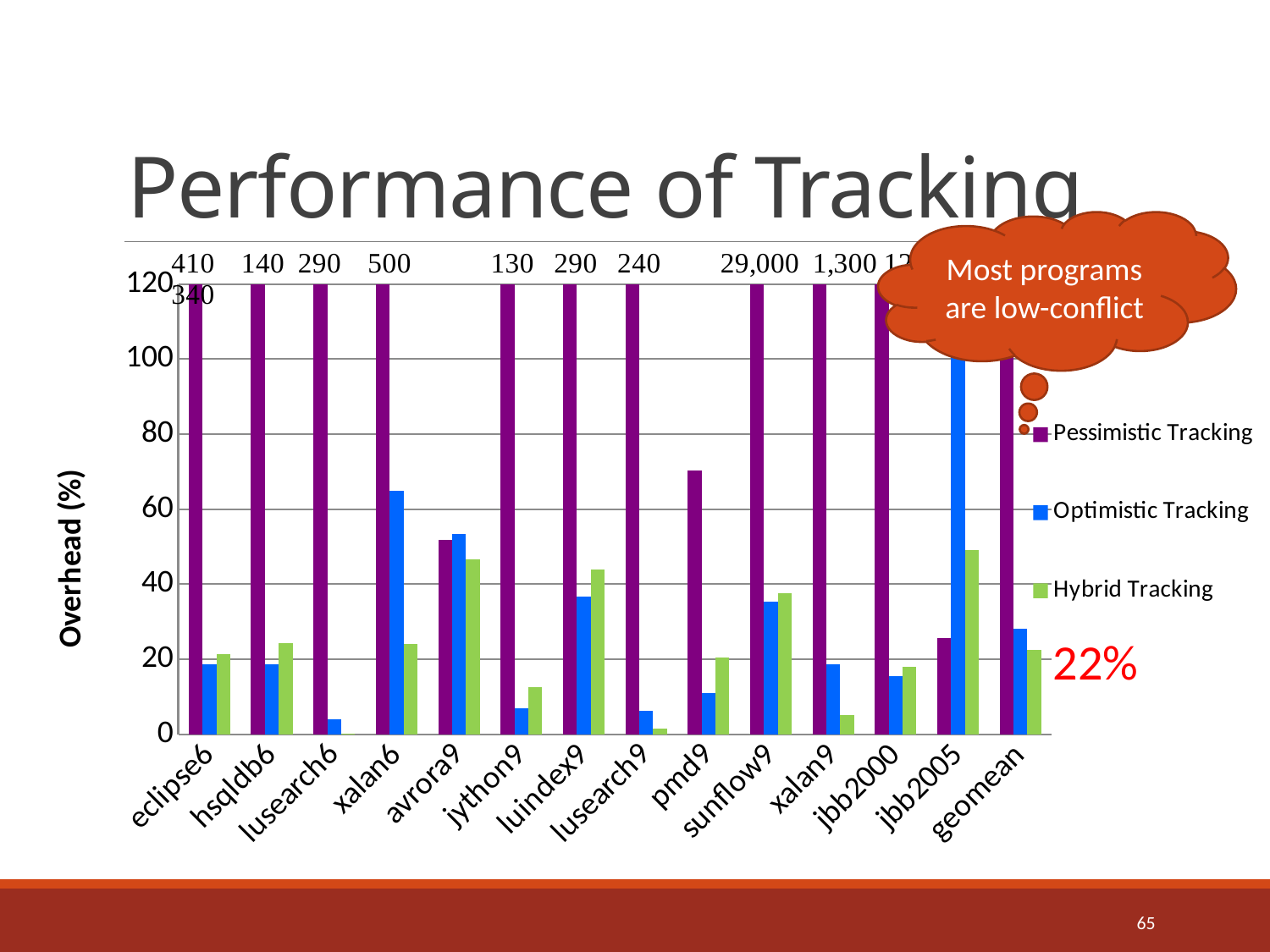
How many categories are shown along the x axis? 14 What value is printed above the Pessimistic Tracking bar for sunflow9? 29,000 Which category has the lowest Optimistic Tracking bar? lusearch6 For xalan6, which is larger: Optimistic Tracking or Hybrid Tracking? Optimistic Tracking How many series does the legend list? 3 What kind of chart is shown on the slide? bar chart What value is printed above the Pessimistic Tracking bar for xalan6? 500 Which series is shown in green in the legend? Hybrid Tracking What is the label of the y axis? Overhead (%) What value is printed above the Pessimistic Tracking bar for xalan9? 1,300 Which category has the highest Optimistic Tracking bar? jbb2005 Is the Pessimistic Tracking value for pmd9 greater or less than 60? greater